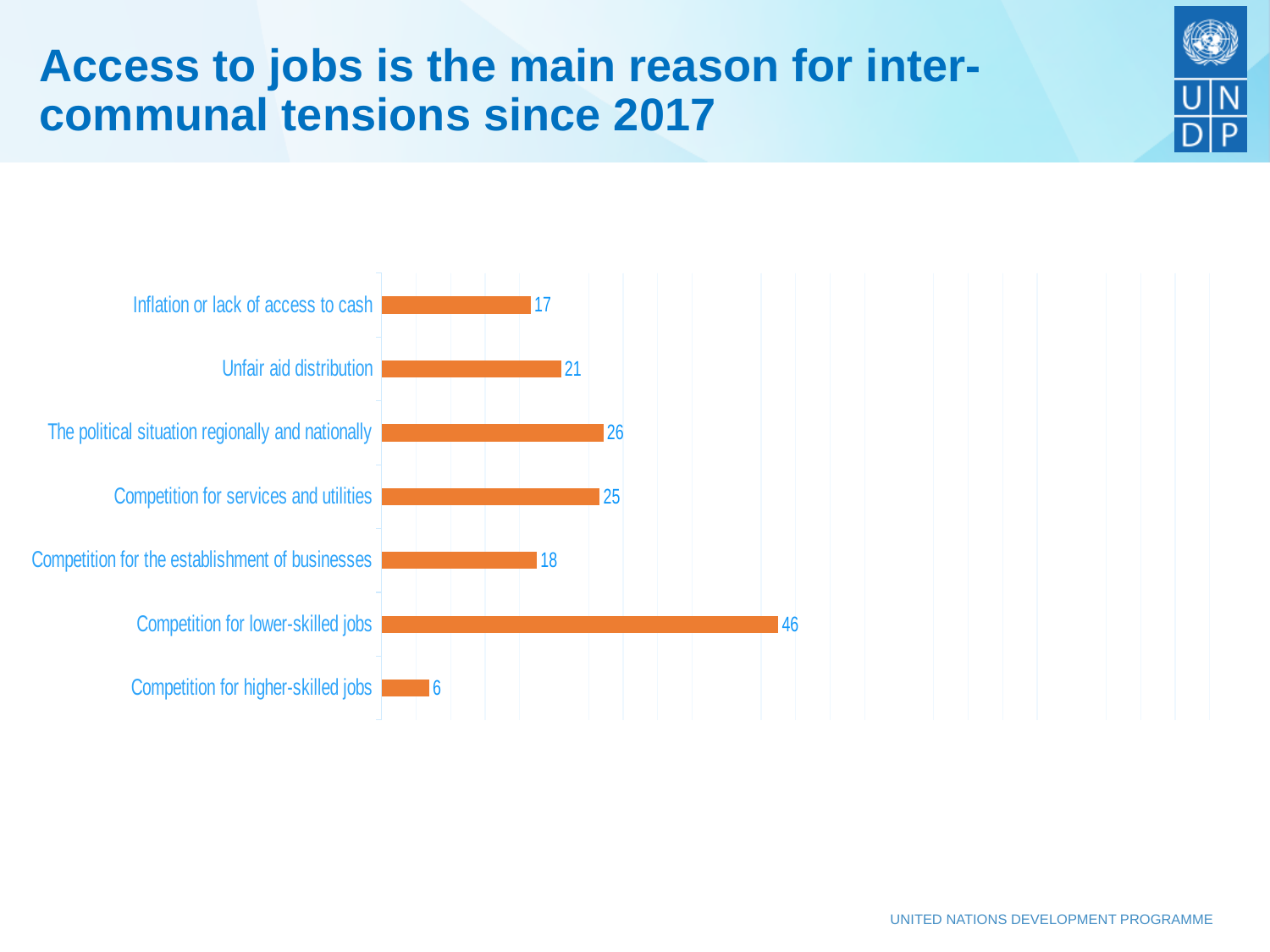
What is the difference between the values for Competition for services and utilities and Competition for the establishment of businesses? 7 Which category has the highest value? Competition for lower-skilled jobs Which category has the lowest value? Competition for higher-skilled jobs What is the value for The political situation regionally and nationally? 26 What is the value for Inflation or lack of access to cash? 17 What is the value for Unfair aid distribution? 21 What is the difference between the values for Competition for lower-skilled jobs and Competition for higher-skilled jobs? 40 What is the value for Competition for lower-skilled jobs? 46 Which is larger: the value for Unfair aid distribution or the value for Inflation or lack of access to cash? Unfair aid distribution What kind of chart is shown on the slide? Bar chart How many categories are shown in the chart? 7 What colour are the bars in the chart? Orange